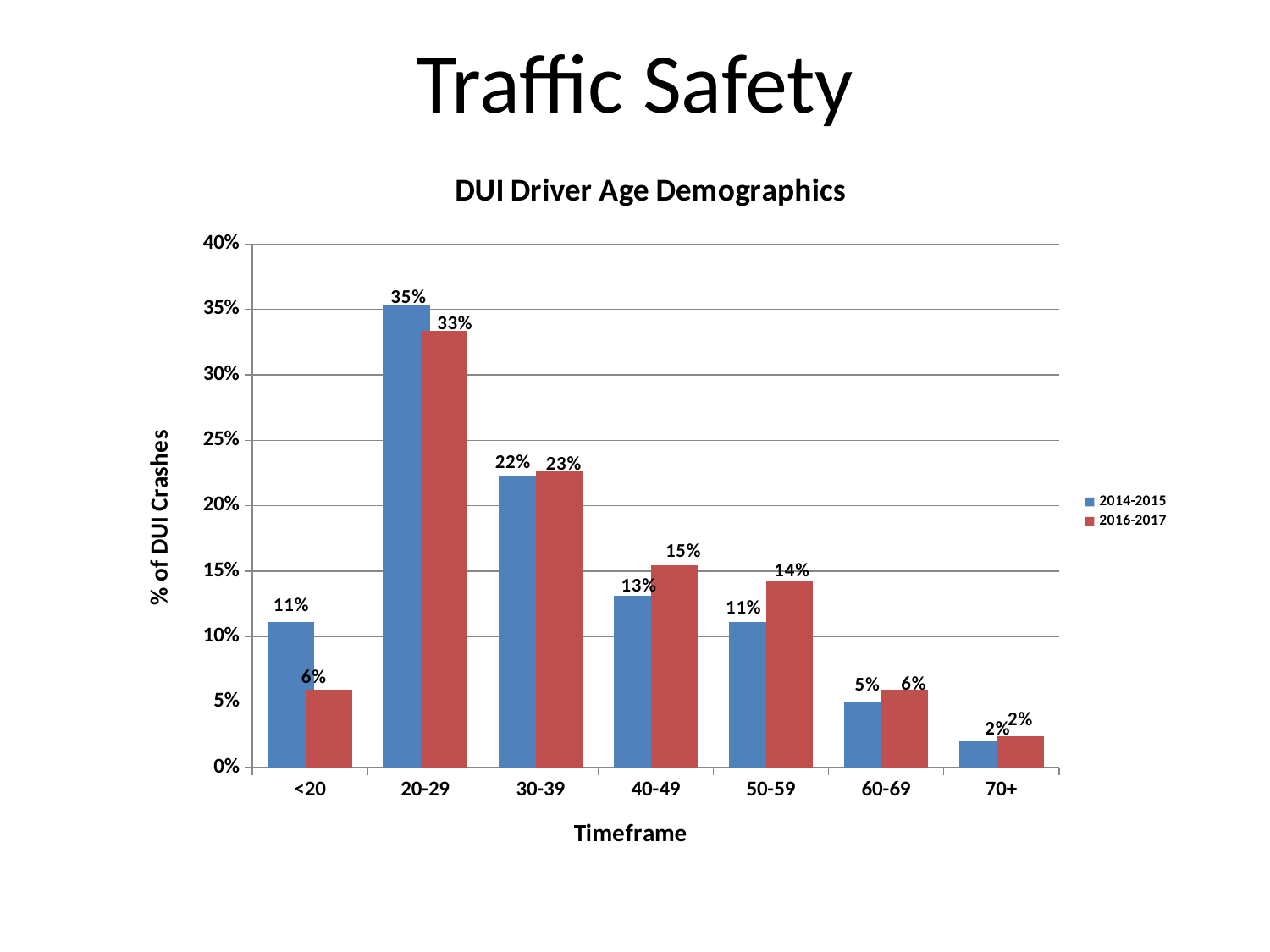
What is the title of the chart? DUI Driver Age Demographics What is the value for the 20-29 age group in the 2014-2015 series? 35% For the 40-49 age group, which series has the larger value, 2014-2015 or 2016-2017? 2016-2017 Which age group has the highest value in the 2014-2015 series? 20-29 What is the difference between the 2014-2015 and 2016-2017 values for the <20 age group? 5% Which age group has the lowest value in the 2016-2017 series? 70+ What is the value for the <20 age group in the 2016-2017 series? 6% What is the value for the 50-59 age group in the 2016-2017 series? 14% What kind of chart is shown on the slide? bar chart Is the 2014-2015 value for the 30-39 age group greater or less than 20%? greater How many series does the legend list? 2 How many age groups are shown on the x axis? 7